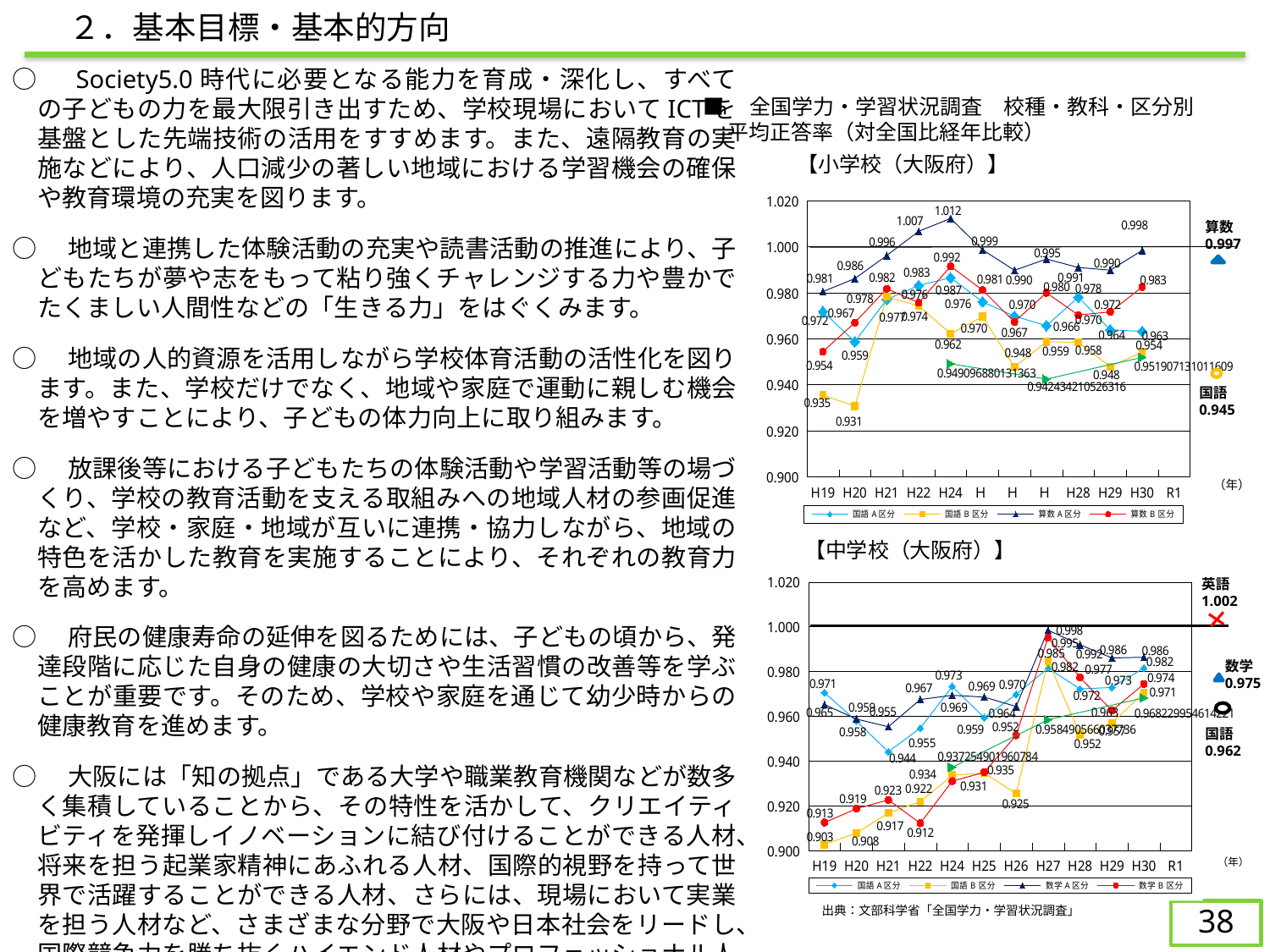
What type of chart is the 【小学校（大阪府）】 chart? line chart In the 【小学校（大阪府）】 chart, what is the difference between the R1 算数 value (0.997) and the R1 国語 value (0.945)? 0.052 In the 【小学校（大阪府）】 chart, in which year does 算数A区分 reach its highest value? H24 How many years are shown on the x axis of the 【中学校（大阪府）】 chart? 12 How many series does the legend of the 【小学校（大阪府）】 chart list? 4 In the 【小学校（大阪府）】 chart, what is the 算数 value shown for R1? 0.997 In the 【小学校（大阪府）】 chart, what is the value of 国語B区分 in H20? 0.931 In the 【中学校（大阪府）】 chart, what is the 英語 value shown for R1? 1.002 In the 【中学校（大阪府）】 chart, which R1 value is larger, 数学 or 国語? 数学 In the 【小学校（大阪府）】 chart, what is the 国語 value shown for R1? 0.945 What source is cited below the charts? 文部科学省「全国学力・学習状況調査」 In the 【小学校（大阪府）】 chart, what is the value of 算数A区分 in H24? 1.012